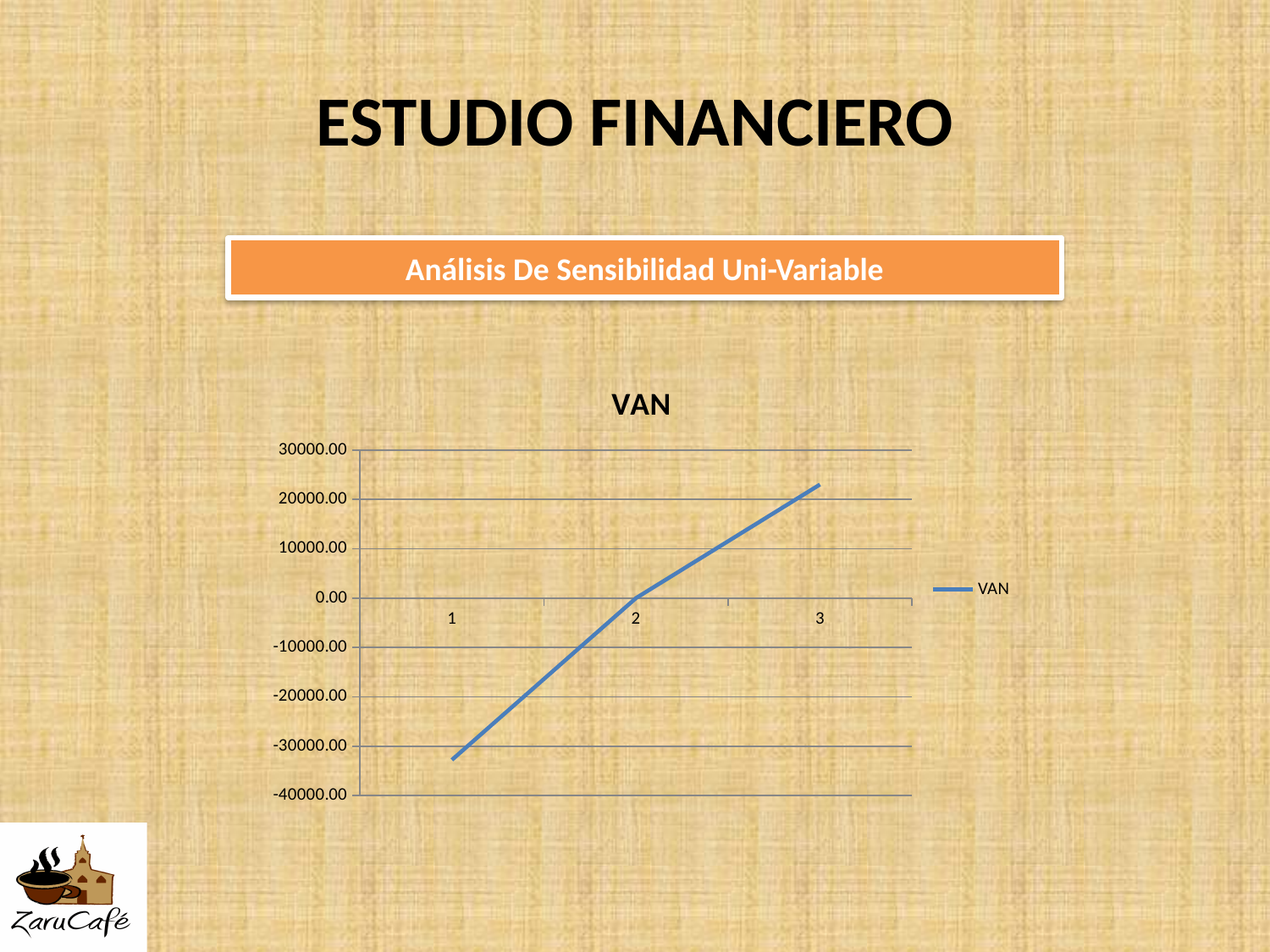
How many points are plotted along the x axis? 3 At which x-axis category is the VAN value lowest? 1 Which has the larger VAN value, category 1 or category 3? 3 At which x-axis category is the VAN value highest? 3 What is the title of the chart? VAN What is the name of the series shown in the legend? VAN Is the VAN value at category 3 greater or less than 20000.00? greater Is the VAN value at category 3 greater or less than 30000.00? less What kind of chart is shown on the slide? line chart How many series does the legend list? 1 Is the VAN value at category 1 greater or less than -30000.00? less Do the VAN values rise or fall from category 1 to category 3? rise